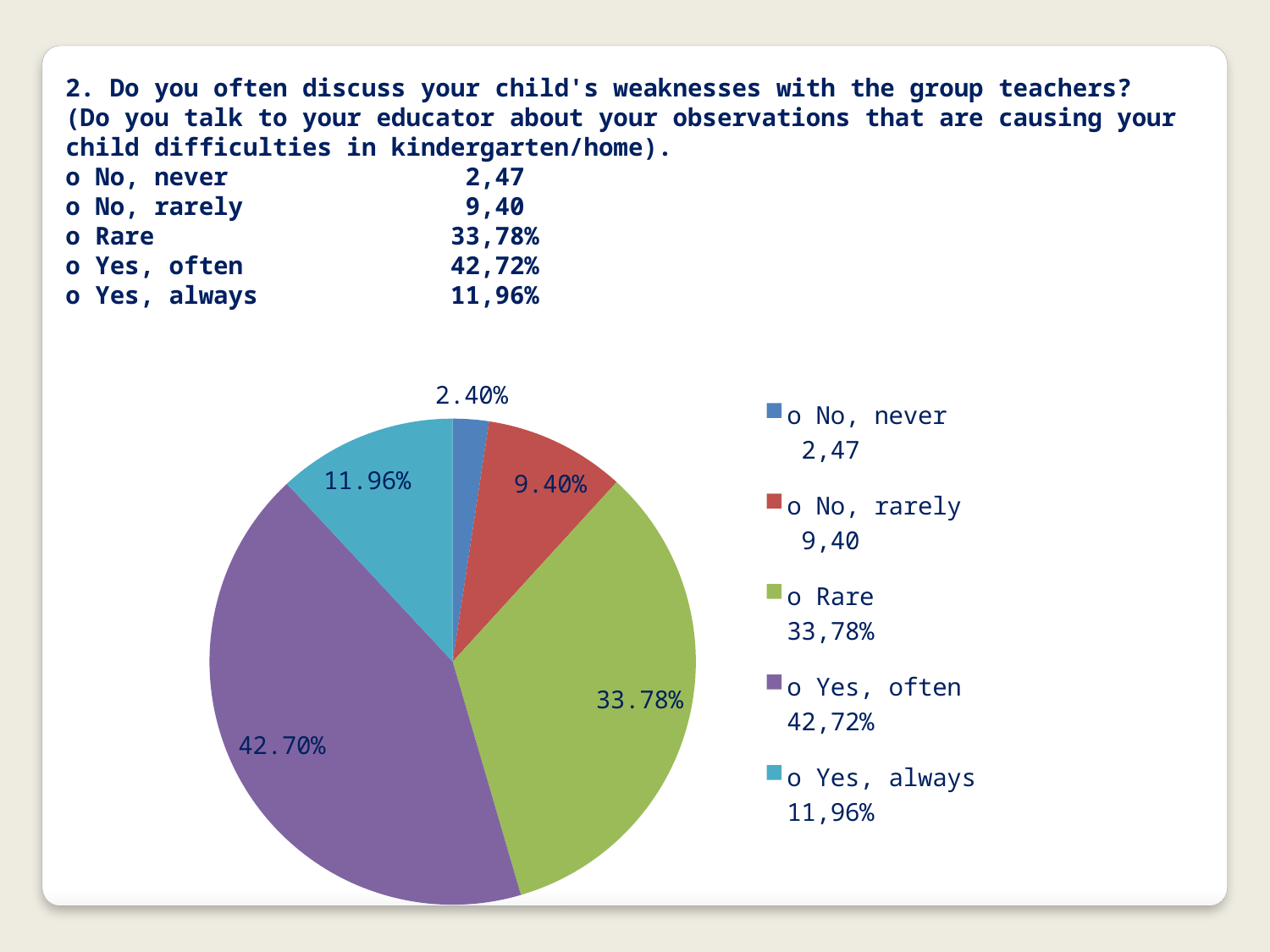
Which category has the smallest slice in the pie chart? No, never What is the data label shown on the pie chart for the 'Yes, always' slice? 11.96% Which slice is larger in the pie chart, 'Rare' or 'Yes, always'? Rare What is the data label shown on the pie chart for the 'No, never' slice? 2.40% What is the data label shown on the pie chart for the 'Yes, often' slice? 42.70% Which category has the largest slice in the pie chart? Yes, often What kind of chart is shown on the slide? pie chart How many entries does the legend of the pie chart list? 5 What colour is the 'Yes, often' slice in the pie chart? purple How many slices does the pie chart have? 5 What is the data label shown on the pie chart for the 'Rare' slice? 33.78% What is the data label shown on the pie chart for the 'No, rarely' slice? 9.40%